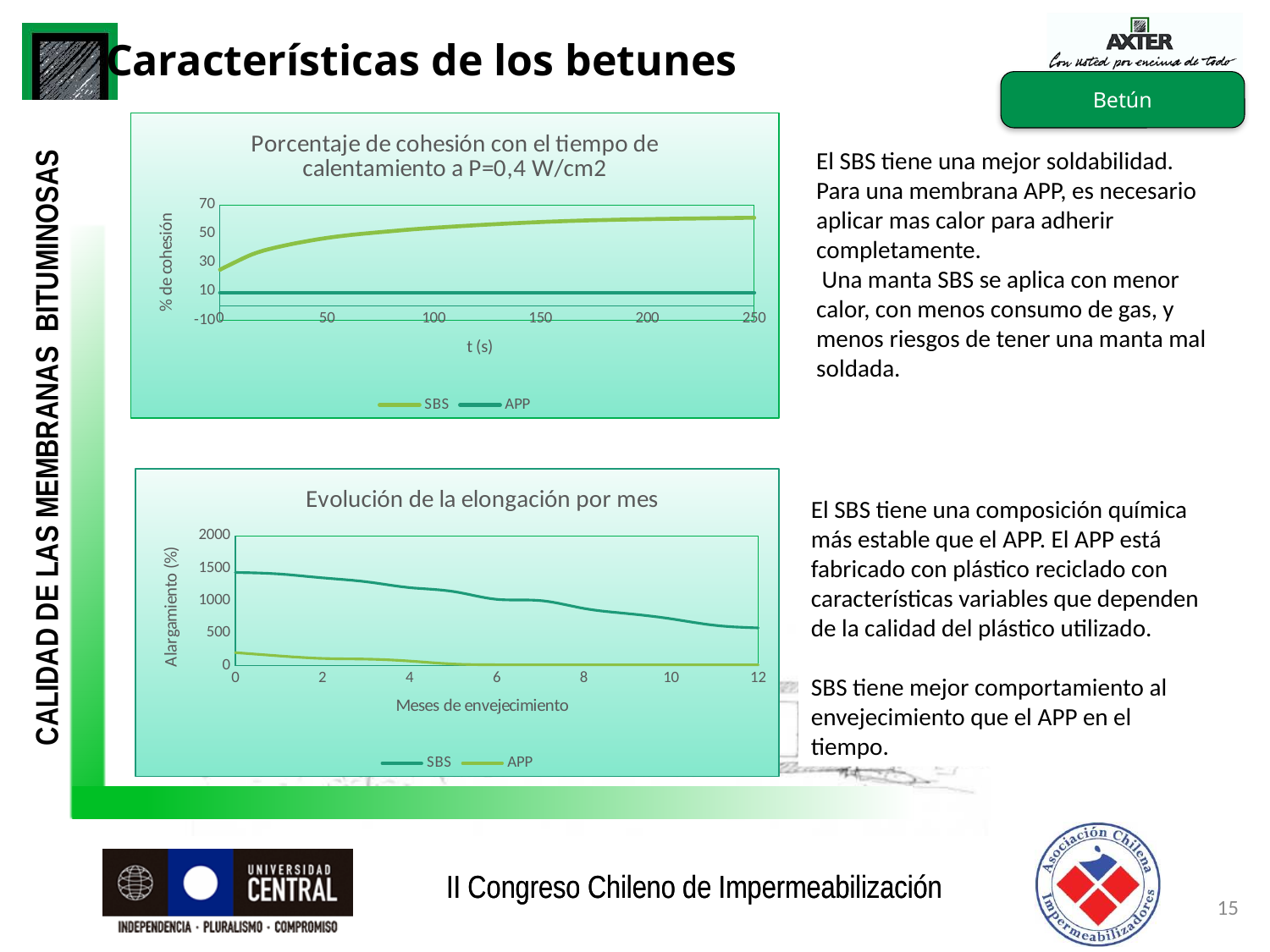
In the chart titled "Evolución de la elongación por mes", what kind of chart is shown? line chart In the chart titled "Porcentaje de cohesión con el tiempo de calentamiento a P=0,4 W/cm2", what kind of chart is shown? line chart In the chart titled "Porcentaje de cohesión con el tiempo de calentamiento a P=0,4 W/cm2", which series has the higher value at t = 200 s, SBS or APP? SBS In the chart titled "Porcentaje de cohesión con el tiempo de calentamiento a P=0,4 W/cm2", is the APP value at t = 100 s greater or less than 30? less In the chart titled "Porcentaje de cohesión con el tiempo de calentamiento a P=0,4 W/cm2", is the SBS value at t = 250 s greater or less than 50? greater In the chart titled "Porcentaje de cohesión con el tiempo de calentamiento a P=0,4 W/cm2", does the SBS line rise or fall as t (s) increases? rises In the chart titled "Evolución de la elongación por mes", is the SBS value at month 0 greater or less than 1000? greater In the chart titled "Porcentaje de cohesión con el tiempo de calentamiento a P=0,4 W/cm2", how many series does the legend list? 2 In the chart titled "Evolución de la elongación por mes", does the SBS line rise or fall as the months of ageing increase? falls In the chart titled "Evolución de la elongación por mes", which series has the higher value at month 6, SBS or APP? SBS In the chart titled "Porcentaje de cohesión con el tiempo de calentamiento a P=0,4 W/cm2", what is the label of the x axis? t (s)